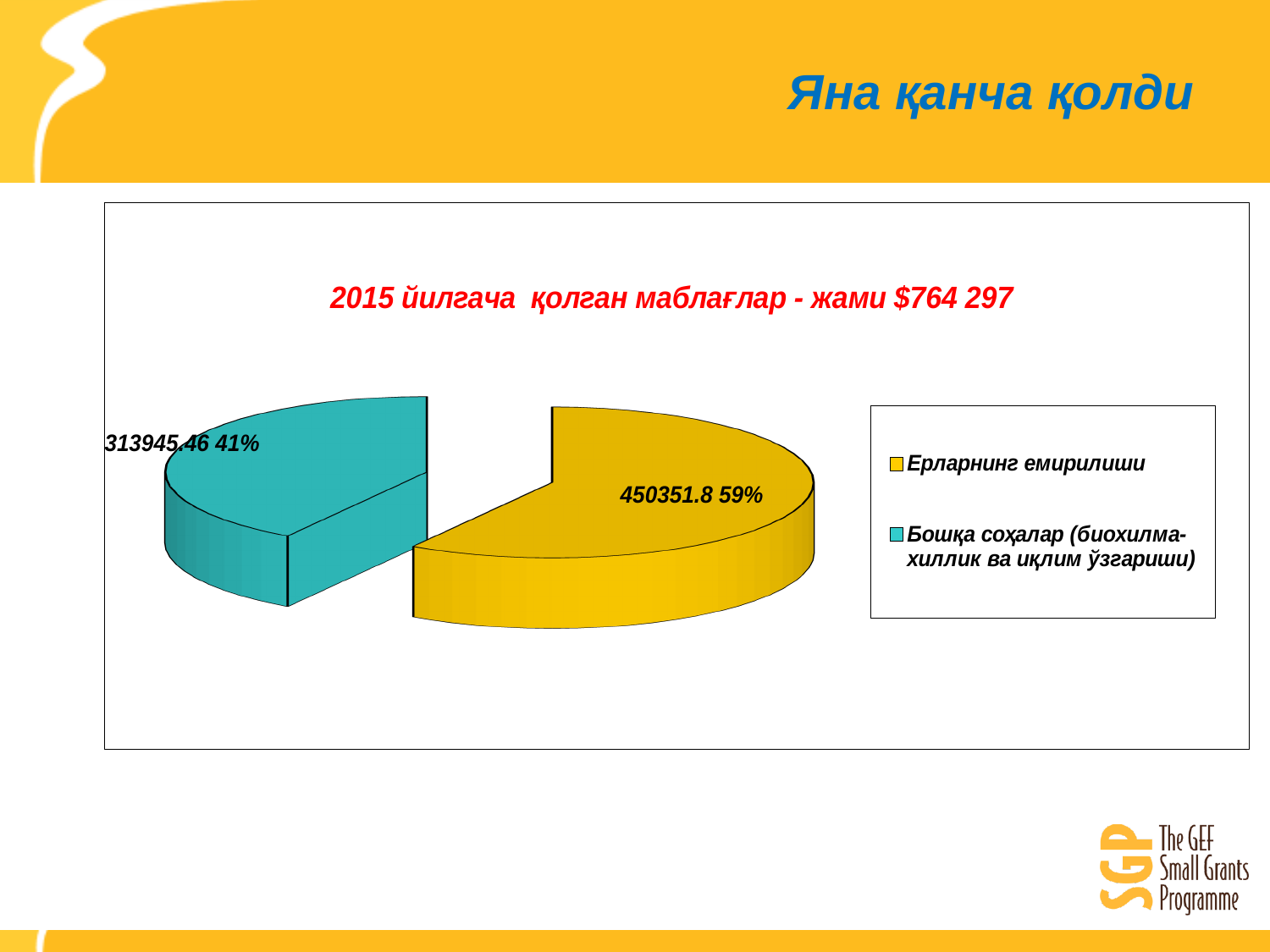
What is the title of the chart? 2015 йилгача қолган маблағлар - жами $764 297 Which slice is the largest? Ерларнинг емирилиши How many slices does the pie chart have? 2 What colour is the slice for "Ерларнинг емирилиши"? yellow Which is larger, the value for "Ерларнинг емирилиши" or for "Бошқа соҳалар (биохилма-хиллик ва иқлим ўзгариши)"? Ерларнинг емирилиши What kind of chart is shown on the slide? pie chart What share of the pie does "Бошқа соҳалар (биохилма-хиллик ва иқлим ўзгариши)" represent? 41% Which slice is the smallest? Бошқа соҳалар (биохилма-хиллик ва иқлим ўзгариши) What value is shown for the slice "Бошқа соҳалар (биохилма-хиллик ва иқлим ўзгариши)"? 313945.46 What value is shown for the slice "Ерларнинг емирилиши"? 450351.8 What share of the pie does "Ерларнинг емирилиши" represent? 59% How many entries does the legend list? 2